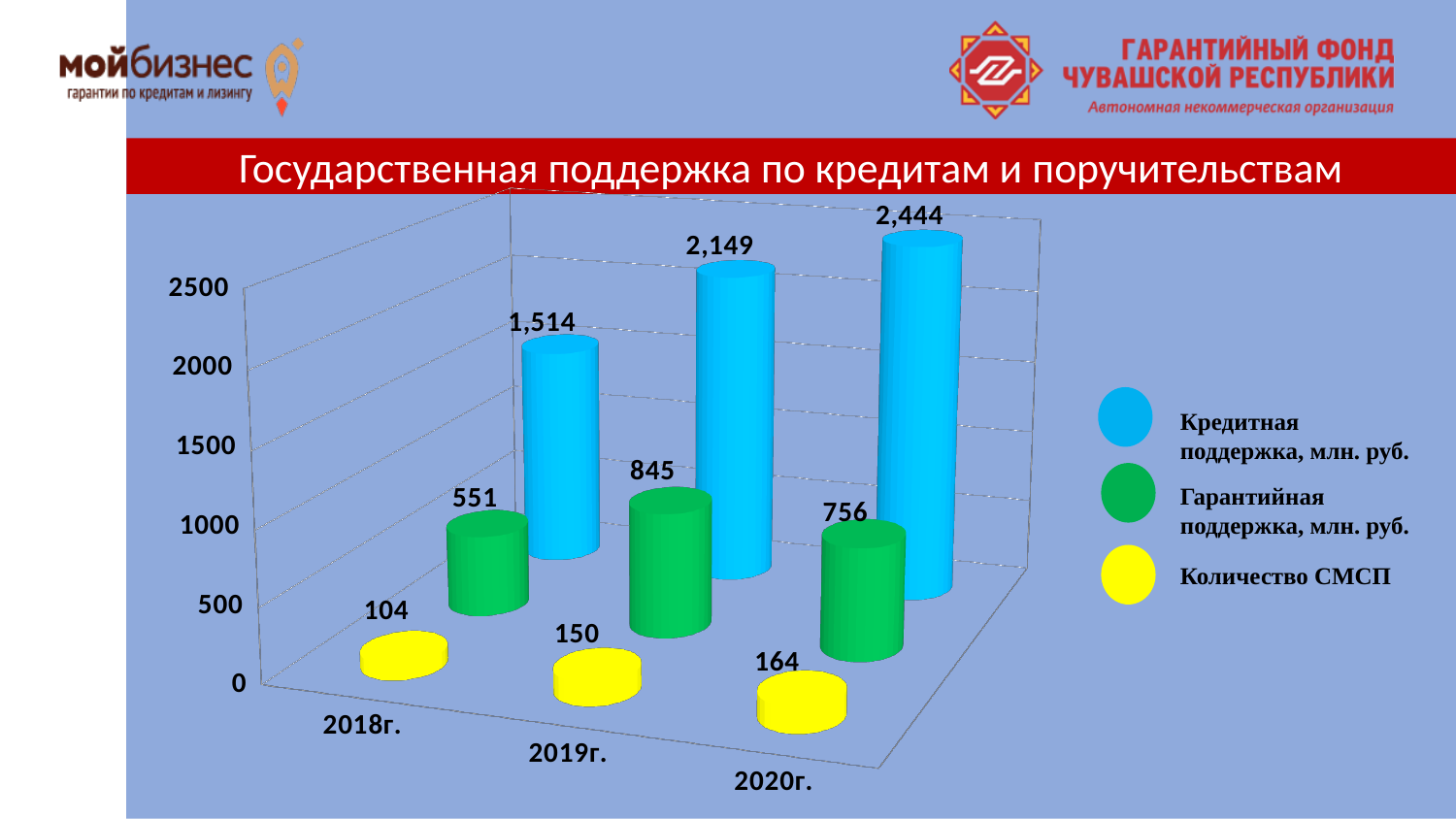
In which year is Кредитная поддержка, млн. руб. the highest? 2020г. Does Количество СМСП rise or fall from 2018г. to 2020г.? rise What is the value of Гарантийная поддержка, млн. руб. for 2019г.? 845 How many series does the legend list? 3 What is the value of Кредитная поддержка, млн. руб. for 2020г.? 2,444 Is the value of Кредитная поддержка, млн. руб. for 2018г. greater or less than 1000? greater What is the difference between Кредитная поддержка, млн. руб. in 2019г. and 2018г.? 635 In which year is Гарантийная поддержка, млн. руб. the lowest? 2018г. What is the value of Количество СМСП for 2018г.? 104 How many years are shown on the x axis of the chart? 3 Which is larger: Гарантийная поддержка, млн. руб. in 2019г. or in 2020г.? 2019г. What kind of chart is shown on the slide? bar chart